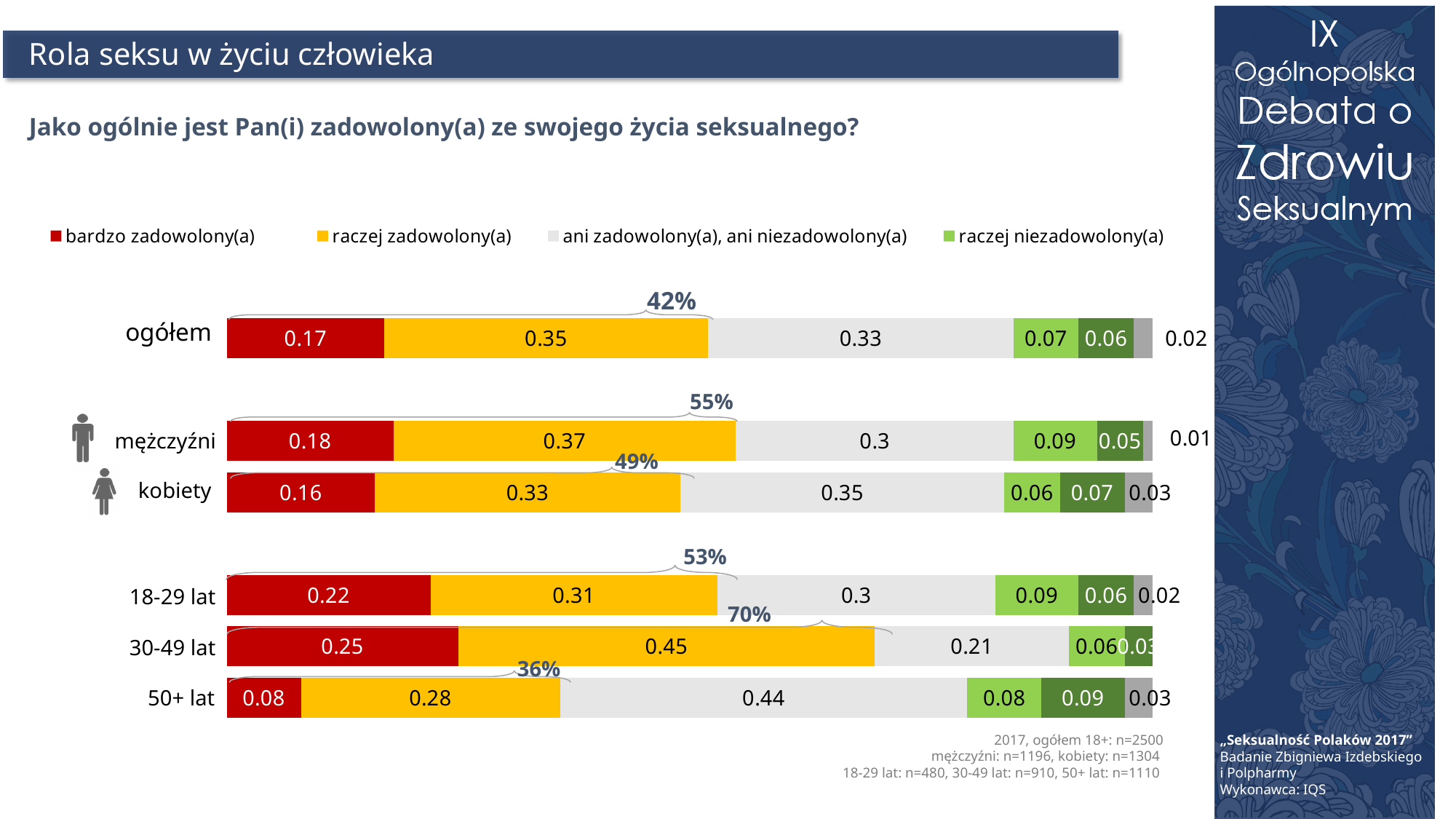
Which category has the highest value for 'bardzo zadowolony(a)'? 30-49 lat How many series does the legend list? 4 What is the value for 'raczej niezadowolony(a)' in the mężczyźni category? 0.09 Which has the larger 'bardzo zadowolony(a)' value, mężczyźni or kobiety? mężczyźni What is the value for 'bardzo zadowolony(a)' in the 30-49 lat category? 0.25 What kind of chart is shown on the slide? stacked bar chart Which category has the lowest value for 'bardzo zadowolony(a)'? 50+ lat What is the value for 'raczej zadowolony(a)' in the 50+ lat category? 0.28 What is the difference between the 'raczej zadowolony(a)' values for 30-49 lat and 50+ lat? 0.17 How many categories (bars) are shown in the chart? 6 What is the value for 'ani zadowolony(a), ani niezadowolony(a)' in the kobiety category? 0.35 Which category has the highest value for 'ani zadowolony(a), ani niezadowolony(a)'? 50+ lat